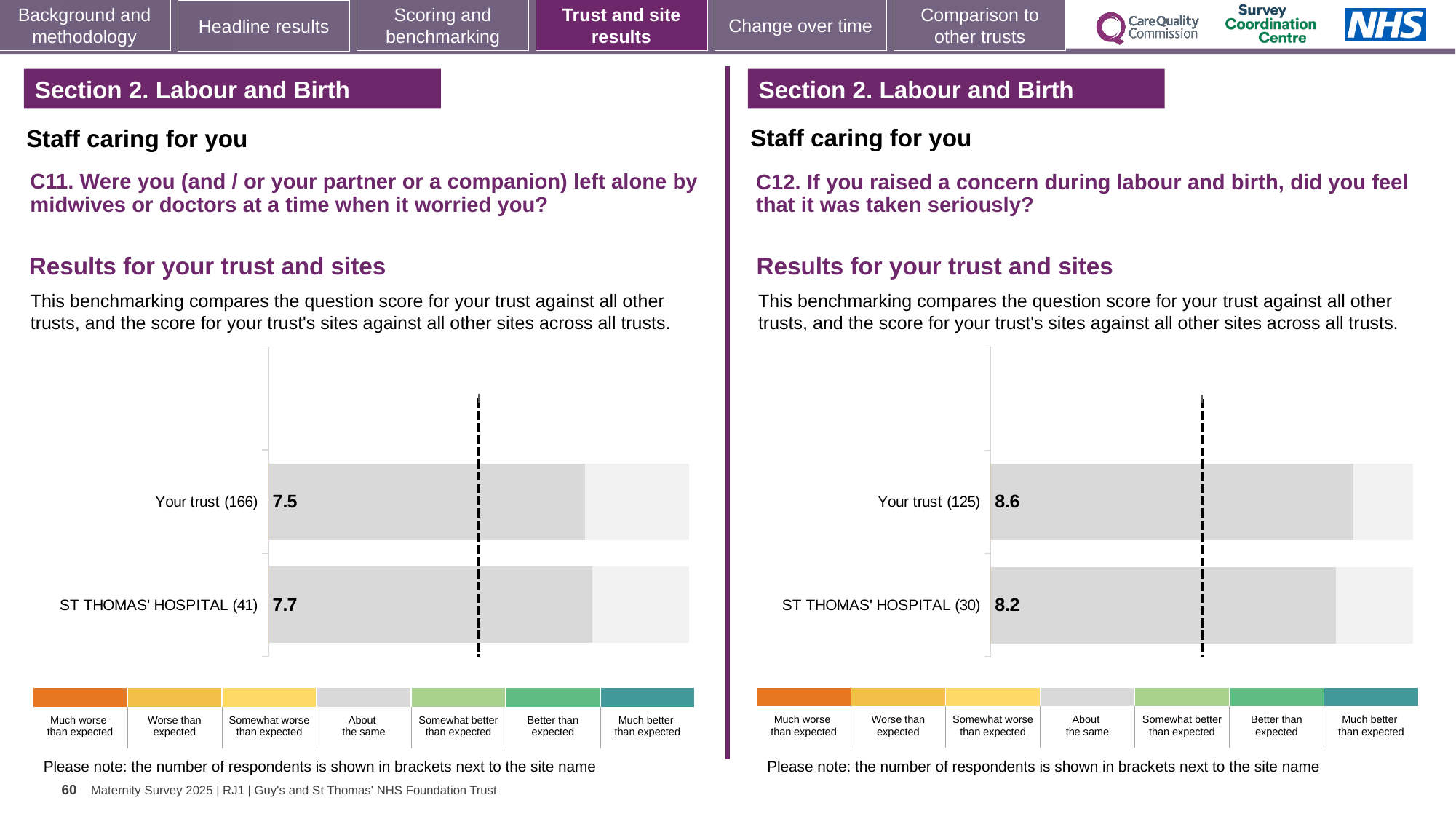
In the C12 chart on the right, what is the difference between the Your trust score and the ST THOMAS' HOSPITAL score? 0.4 In the C12 chart on the right, how many respondents are shown in brackets for ST THOMAS' HOSPITAL? 30 In the C12 chart on the right, what is the score for Your trust? 8.6 In the C11 chart on the left, what is the score for Your trust? 7.5 In the C11 chart on the left, which has the higher score, Your trust or ST THOMAS' HOSPITAL? ST THOMAS' HOSPITAL In the C11 chart on the left, what is the score for ST THOMAS' HOSPITAL? 7.7 In the C11 chart on the left, how many respondents are shown in brackets for Your trust? 166 In the C12 chart on the right, what is the score for ST THOMAS' HOSPITAL? 8.2 How many bars are plotted in the C12 chart on the right? 2 In the C12 chart on the right, which has the lower score, Your trust or ST THOMAS' HOSPITAL? ST THOMAS' HOSPITAL What type of chart is used for the C11 results on the left? Bar chart In the C11 chart on the left, what is the difference between the ST THOMAS' HOSPITAL score and the Your trust score? 0.2